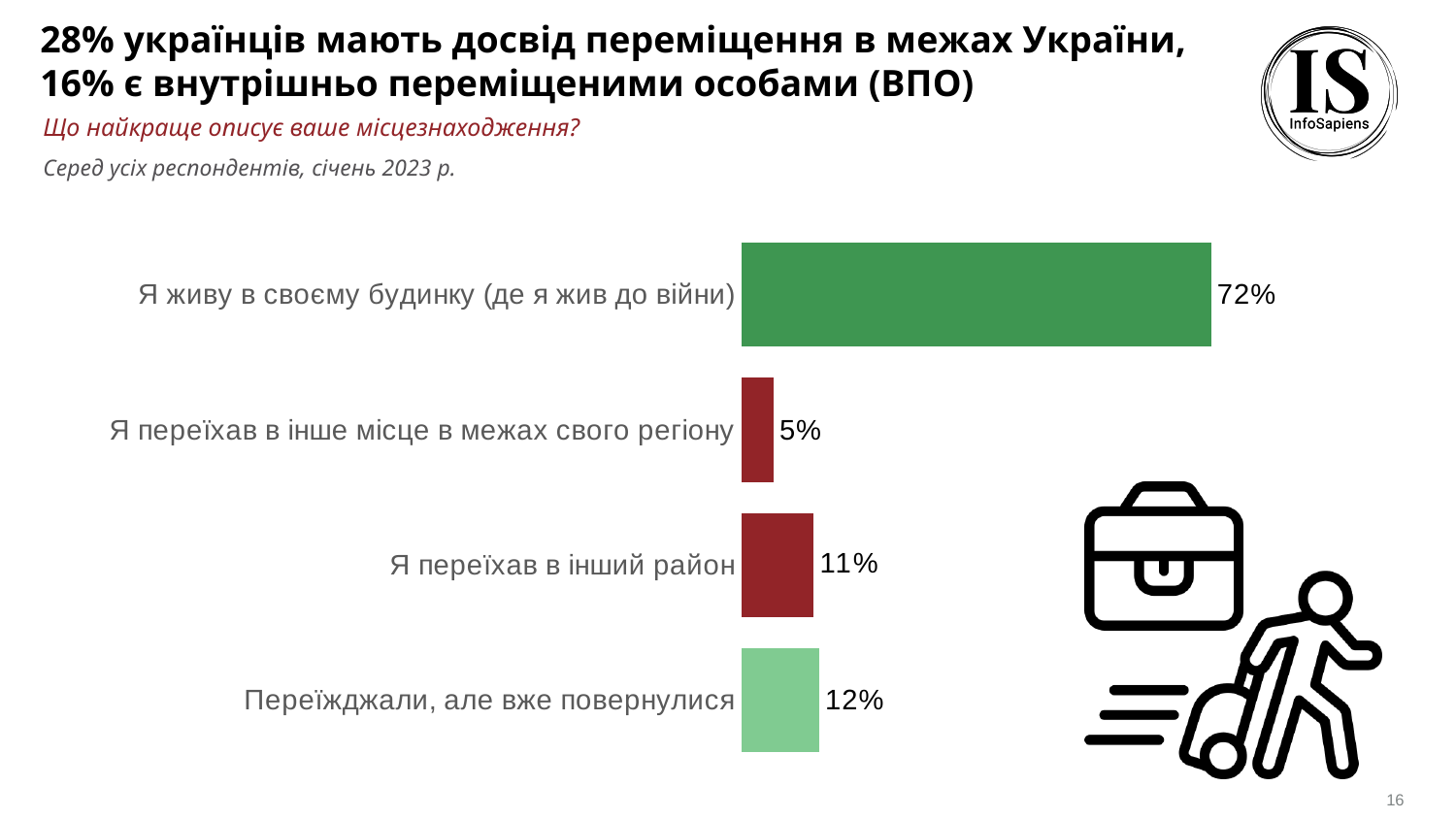
What is the value for "Я живу в своєму будинку (де я жив до війни)"? 72% What kind of chart is shown on the slide? Bar chart What is the value for "Я переїхав в інше місце в межах свого регіону"? 5% Which category has the highest value? Я живу в своєму будинку (де я жив до війни) Which is larger: the value for "Переїжджали, але вже повернулися" or the value for "Я переїхав в інший район"? Переїжджали, але вже повернулися What is the value for "Переїжджали, але вже повернулися"? 12% What is the difference between the values for "Я живу в своєму будинку (де я жив до війни)" and "Переїжджали, але вже повернулися"? 60% What is the difference between the values for "Я переїхав в інший район" and "Я переїхав в інше місце в межах свого регіону"? 6% Which category has the lowest value? Я переїхав в інше місце в межах свого регіону How many categories are shown in the chart? 4 What is the value for "Я переїхав в інший район"? 11% What colour is the bar for "Я живу в своєму будинку (де я жив до війни)"? Green